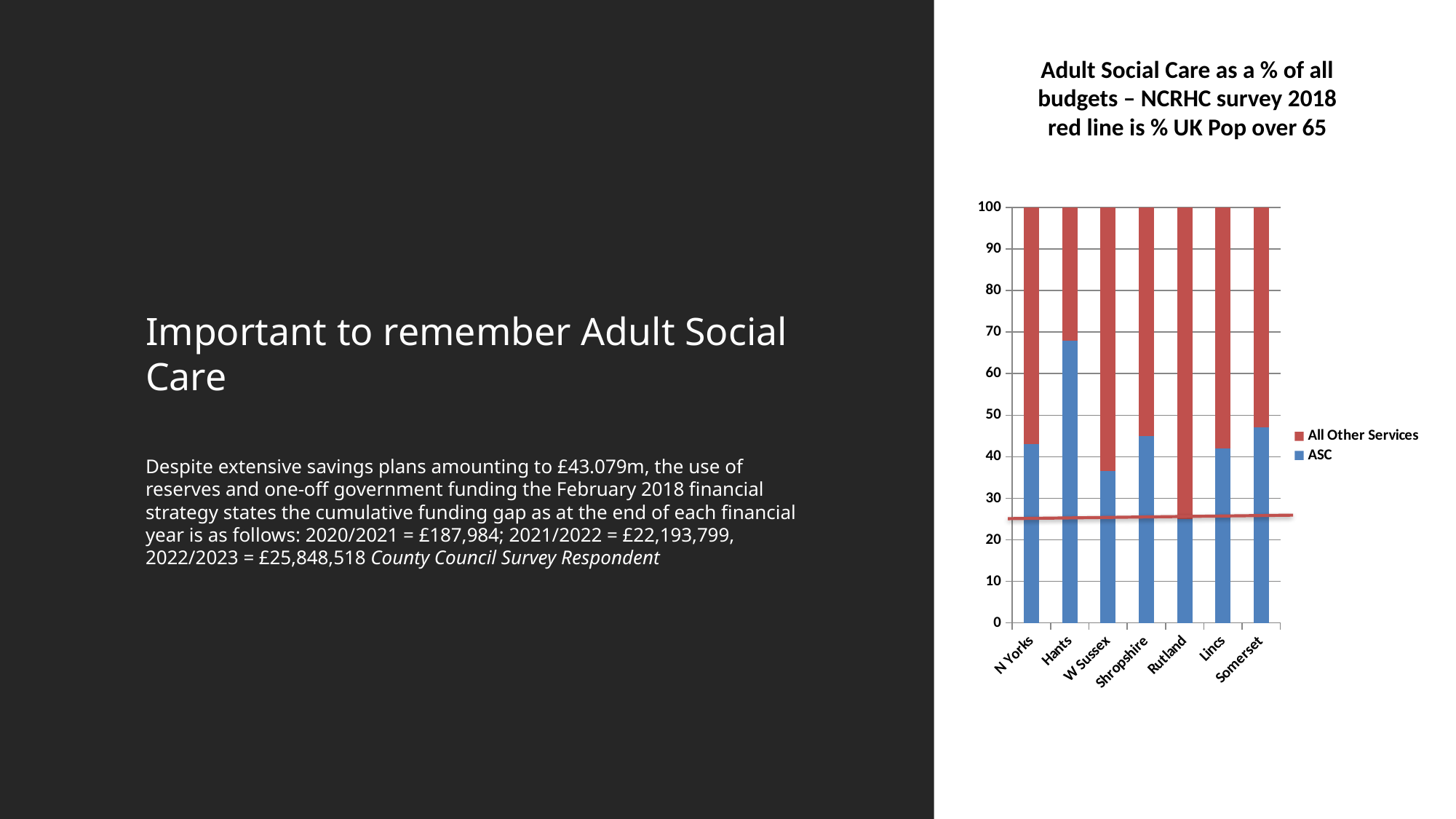
What is the total height of each stacked bar in the chart? 100 Is the ASC value for W Sussex greater or less than 40? less How many counties are shown on the x axis of the chart? 7 Is the ASC value for Somerset greater or less than 50? less Which has a larger ASC share, Hants or W Sussex? Hants Is the ASC value for Rutland greater or less than 30? less What kind of chart is shown on the slide? Stacked bar chart Which county has the highest ASC share of its budget? Hants According to the chart title, what does the red line represent? % UK Pop over 65 Which county has the lowest ASC share of its budget? Rutland How many series does the chart's legend list? 2